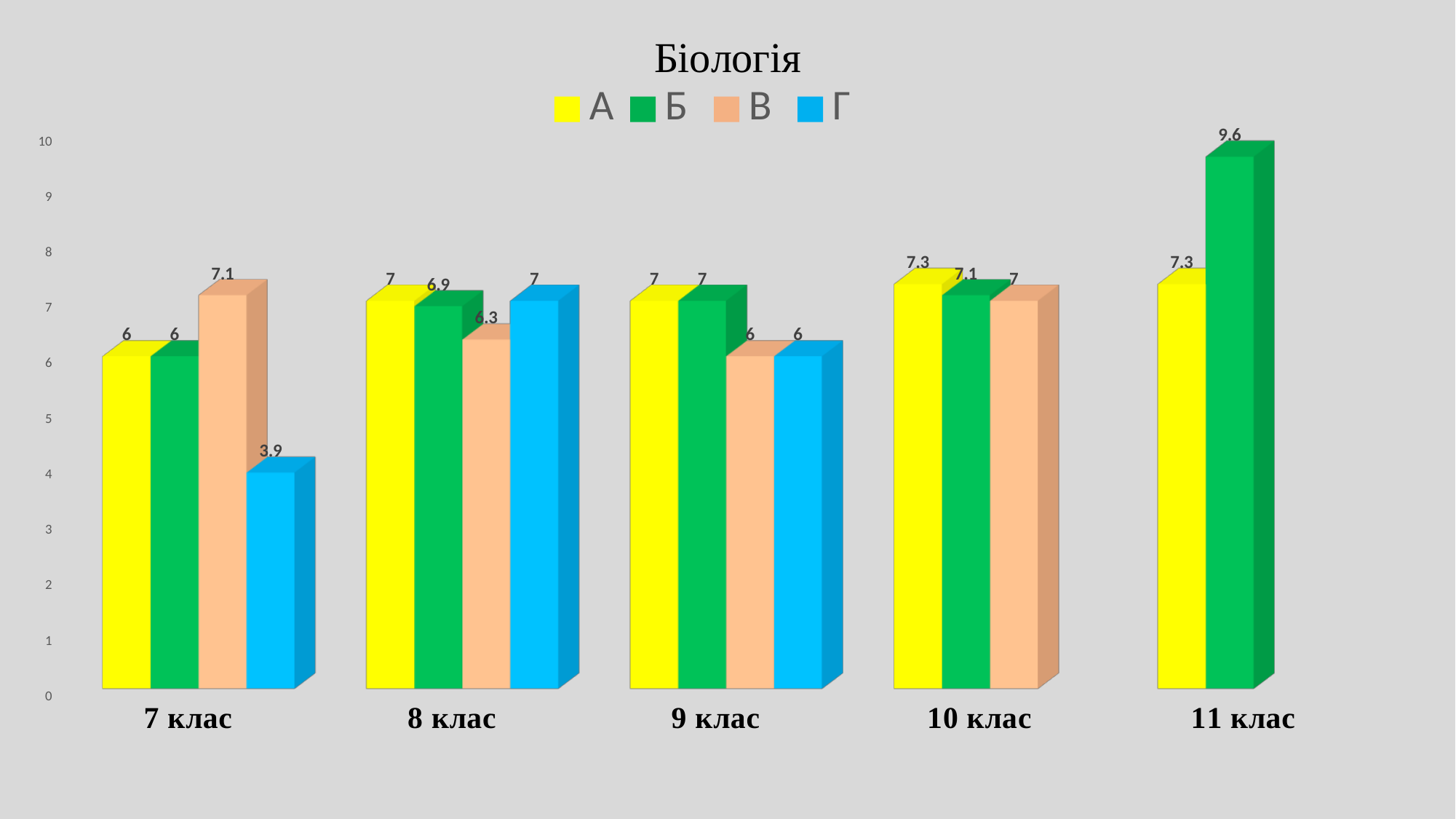
What is the value for series Г in 7 клас? 3.9 Which series has the highest value in 7 клас? В Which is larger in 7 клас: series В or series Г? В How many series does the legend list? 4 What is the difference between series Б and series А in 11 клас? 2.3 How many categories are shown on the x axis? 5 What is the value for series Б in 11 клас? 9.6 What is the title of the chart? Біологія What is the value for series В in 8 клас? 6.3 Which series has the lowest value in 8 клас? В What is the value for series А in 10 клас? 7.3 What kind of chart is shown? bar chart